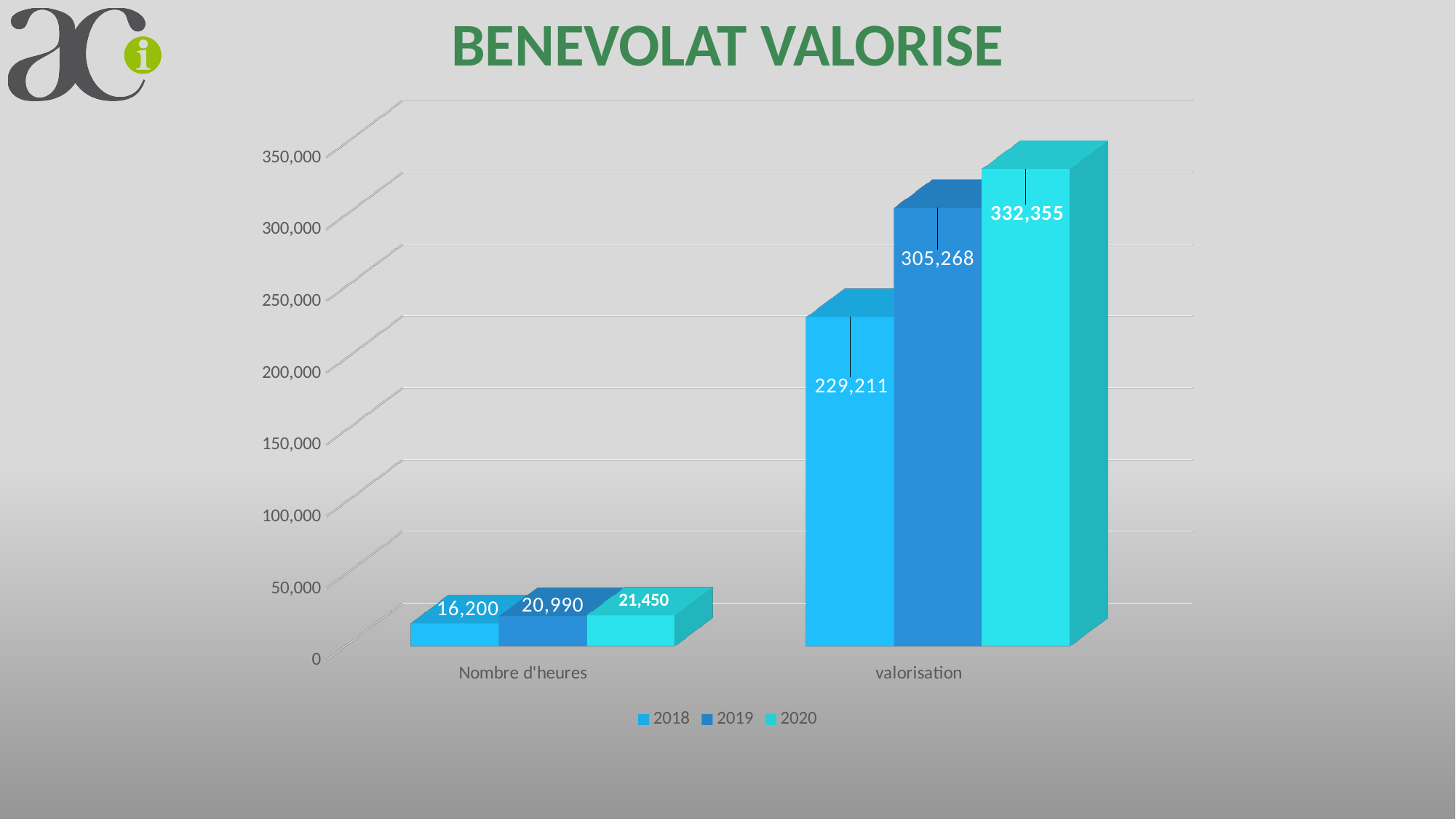
How many series does the legend list? 3 What is the value for 2019 in the valorisation category? 305,268 What is the difference between the 2019 and 2018 values in the Nombre d'heures category? 4,790 Which is larger in the valorisation category: the 2018 value or the 2019 value? 2019 What is the title of the chart? BENEVOLAT VALORISE Which year has the lowest value in the Nombre d'heures category? 2018 What is the value for 2020 in the Nombre d'heures category? 21,450 What is the value for 2018 in the valorisation category? 229,211 What kind of chart is shown on the slide? Bar chart Which year has the highest value in the valorisation category? 2020 What is the difference between the 2020 and 2019 values in the valorisation category? 27,087 What is the value for 2018 in the Nombre d'heures category? 16,200